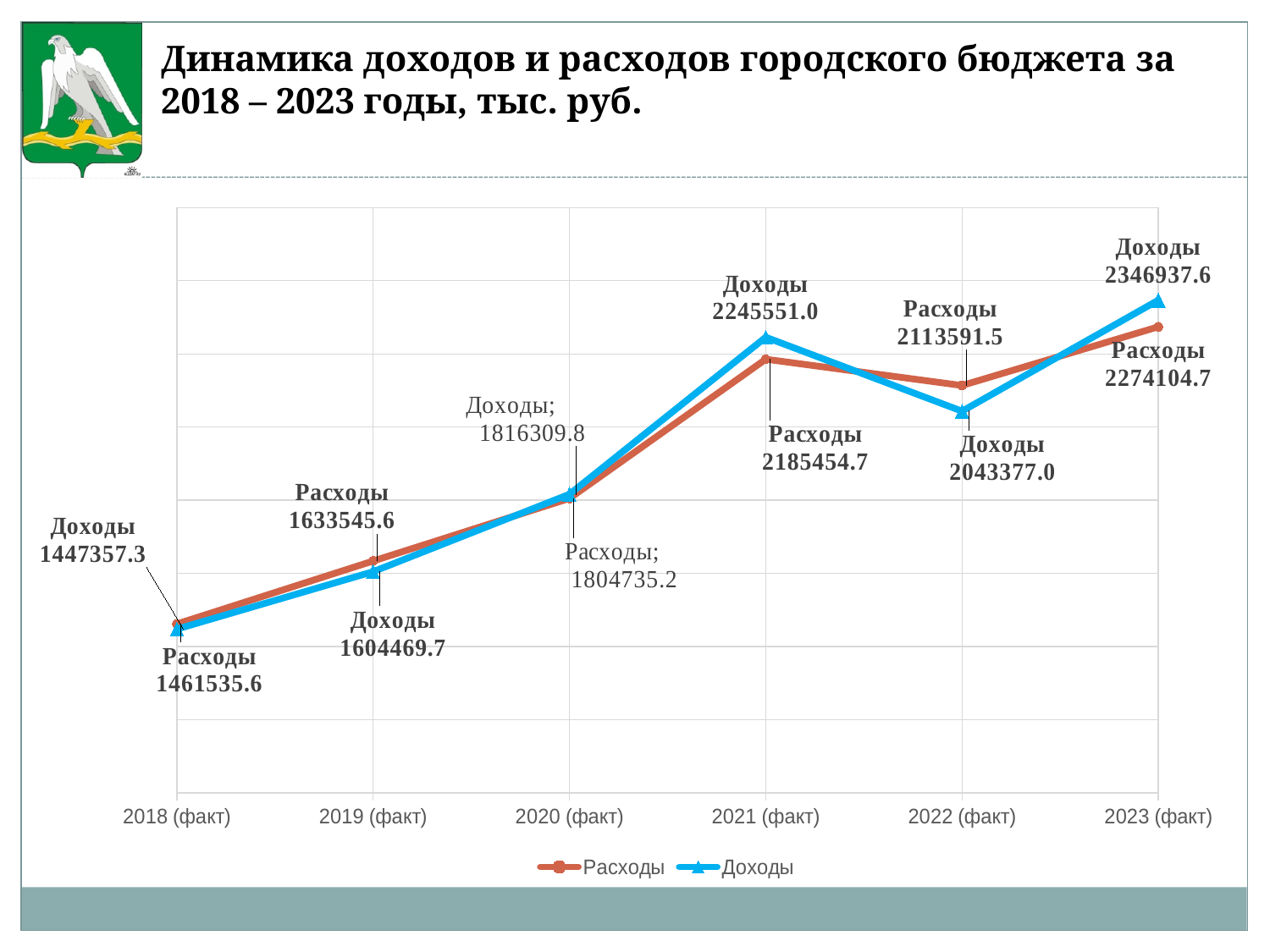
In which year is Доходы the highest? 2023 (факт) In which year is Расходы the lowest? 2018 (факт) What is the difference between Доходы and Расходы in 2021 (факт)? 60096.3 Which is larger in 2022 (факт), Доходы or Расходы? Расходы How many years are shown on the x axis? 6 What is the difference between Доходы and Расходы in 2023 (факт)? 72832.9 What is the value of Расходы for 2018 (факт)? 1461535.6 What kind of chart is shown on the slide? Line chart What is the value of Расходы for 2019 (факт)? 1633545.6 How many series does the legend list? 2 What is the value of Доходы for 2022 (факт)? 2043377.0 What is the value of Доходы for 2021 (факт)? 2245551.0